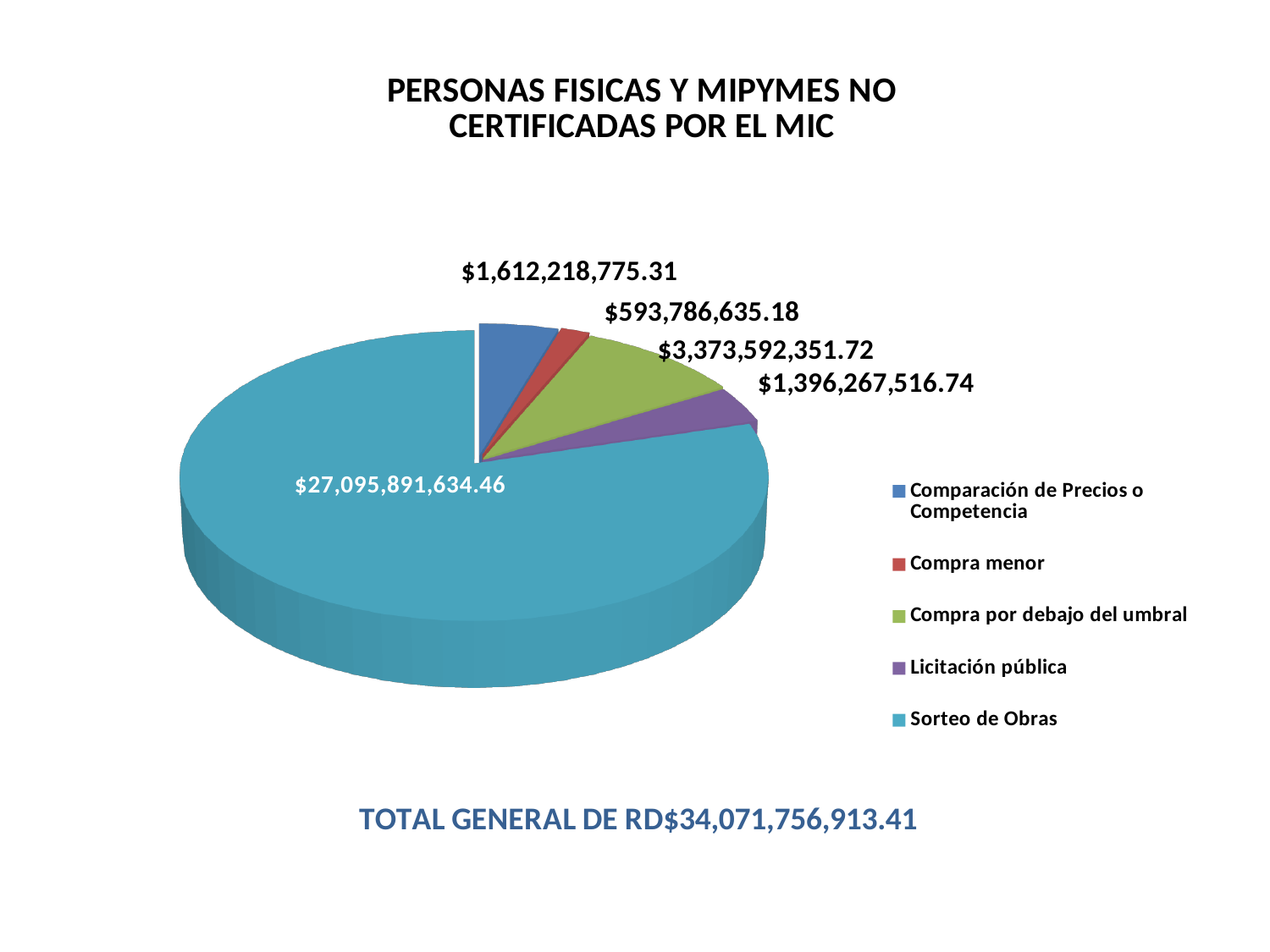
What is the value for Licitación pública? $1,396,267,516.74 What kind of chart is shown on the slide? Pie chart What is the value for Compra menor? $593,786,635.18 Which is larger, the value for Comparación de Precios o Competencia or the value for Licitación pública? Comparación de Precios o Competencia What is the value for Compra por debajo del umbral? $3,373,592,351.72 Which category has the largest slice of the pie? Sorteo de Obras What is the difference between the values for Sorteo de Obras and Compra por debajo del umbral? $23,722,299,282.74 How many categories does the pie chart show? 5 What is the value for Comparación de Precios o Competencia? $1,612,218,775.31 What is the value for Sorteo de Obras? $27,095,891,634.46 What is the total general amount stated below the chart? RD$34,071,756,913.41 Which category has the smallest slice of the pie? Compra menor